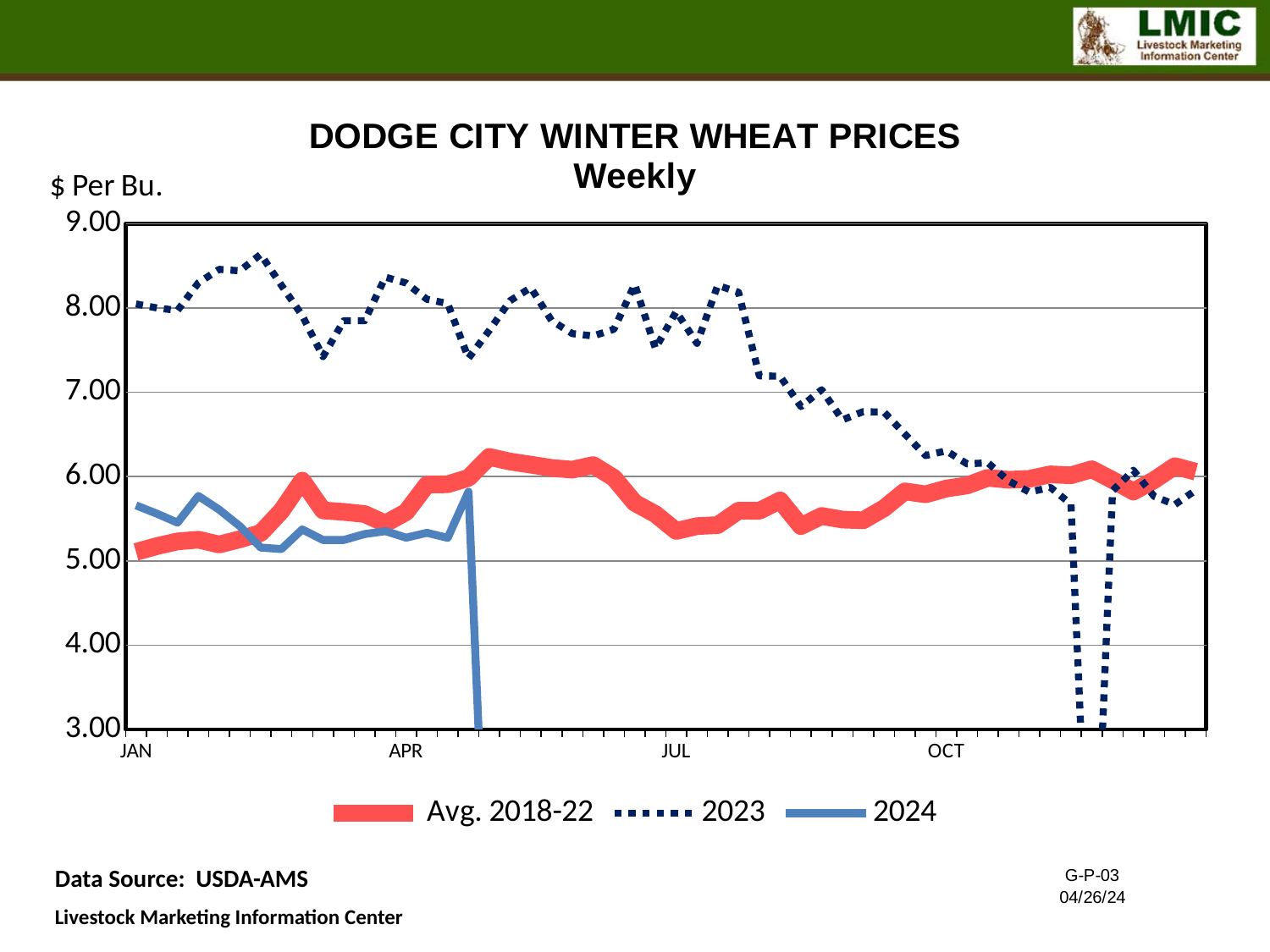
Is the value for 2023 in APR greater or less than 8.00? greater What kind of chart is shown on the slide? Line chart Does the 2023 series rise or fall between JUL and OCT? Fall Is the value for 2024 in JAN greater or less than 5.00? greater In JAN, which series has the higher value, 2023 or Avg. 2018-22? 2023 What is the title of the chart? DODGE CITY WINTER WHEAT PRICES Weekly What unit is shown on the y axis of the chart? $ Per Bu. Is the value for 2023 in JAN greater or less than 7.00? greater How many series does the legend list? 3 In JAN, which series has the higher value, 2024 or Avg. 2018-22? 2024